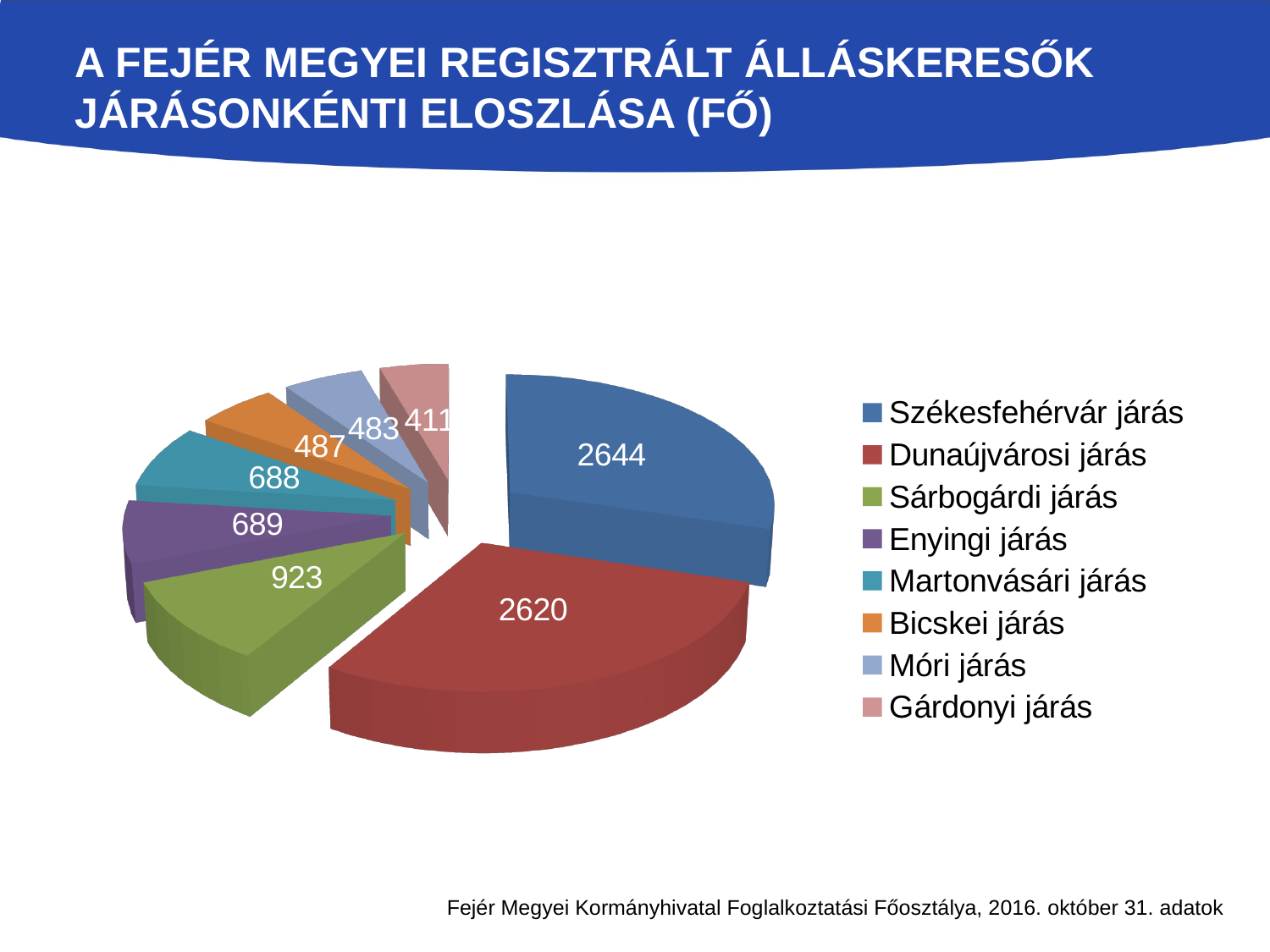
Which is larger, the value for Sárbogárdi járás or the value for Martonvásári járás? Sárbogárdi járás What kind of chart is shown on the slide? Pie chart What is the value for Móri járás? 483 What is the value for Sárbogárdi járás? 923 What is the value for Bicskei járás? 487 What is the difference between the values for Székesfehérvár járás and Dunaújvárosi járás? 24 How many districts are shown in the pie chart? 8 What is the value for Dunaújvárosi járás? 2620 What is the difference between the values for Sárbogárdi járás and Enyingi járás? 234 Which district has the highest number of registered job seekers? Székesfehérvár járás What colour is the slice for Enyingi járás? Purple Which district has the lowest number of registered job seekers? Gárdonyi járás